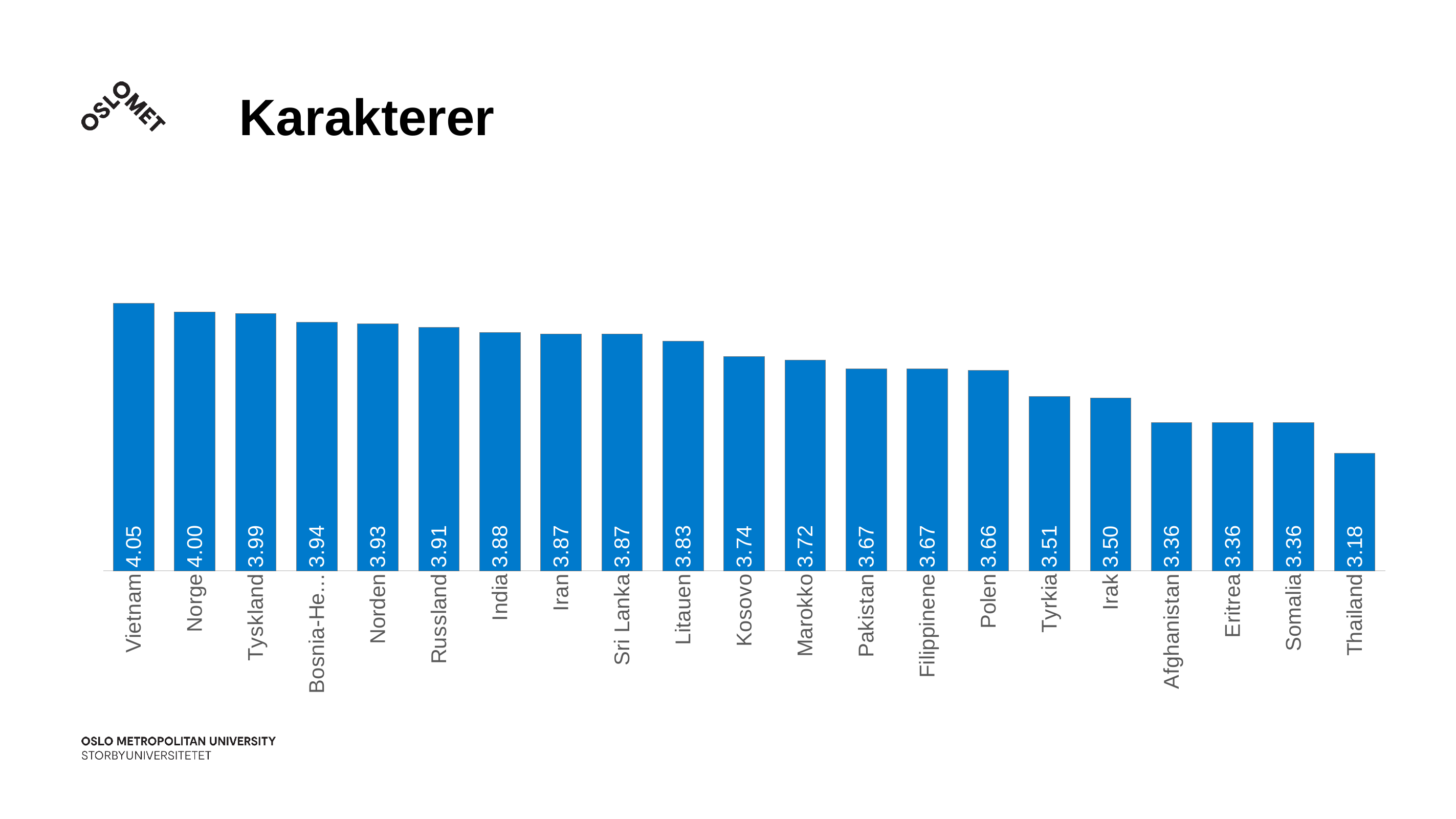
Which category has the highest value? Vietnam What is the title of the chart? Karakterer What is the value for Pakistan? 3.67 Which category has the lowest value? Thailand What is the difference between the values for Norge and Thailand? 0.82 Do the values rise or fall from left to right along the x axis? fall What is the difference between the values for Kosovo and Tyrkia? 0.23 Which has a larger value, Litauen or Polen? Litauen What is the value for Vietnam? 4.05 What is the value for Irak? 3.50 What kind of chart is shown on the slide? bar chart How many countries/categories are shown in the chart? 21